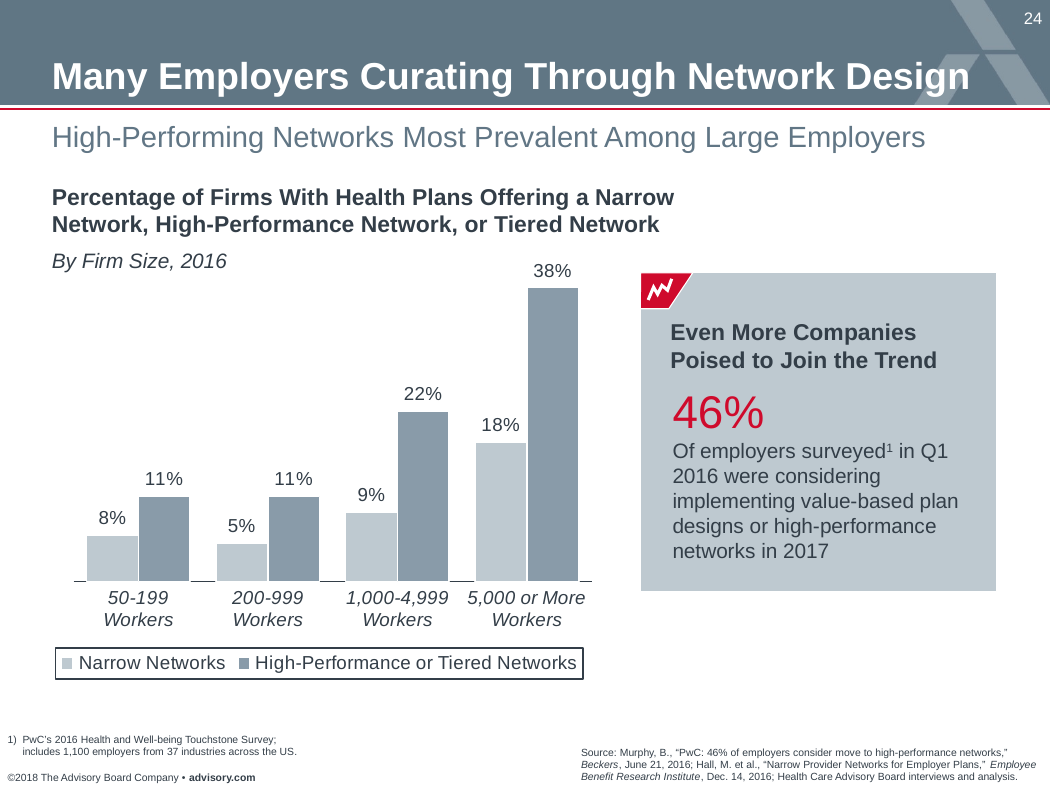
What year does the chart subtitle say the data is from? 2016 What is the difference between the high-performance or tiered networks value and the narrow networks value for firms with 5,000 or more workers? 20% How many firm size categories are shown on the chart? 4 Does the value for high-performance or tiered networks rise or fall as firm size increases from 200-999 workers to 5,000 or more workers? Rise Which firm size category has the lowest value for narrow networks? 200-999 Workers How many series does the chart legend list? 2 Which is larger for firms with 200-999 workers: narrow networks or high-performance or tiered networks? High-Performance or Tiered Networks Which firm size category has the highest value for high-performance or tiered networks? 5,000 or More Workers What percentage of firms with 5,000 or more workers offer high-performance or tiered networks? 38% What percentage of firms with 50-199 workers offer narrow networks? 8% What kind of chart is shown on the slide? Bar chart What is the value for narrow networks among firms with 1,000-4,999 workers? 9%